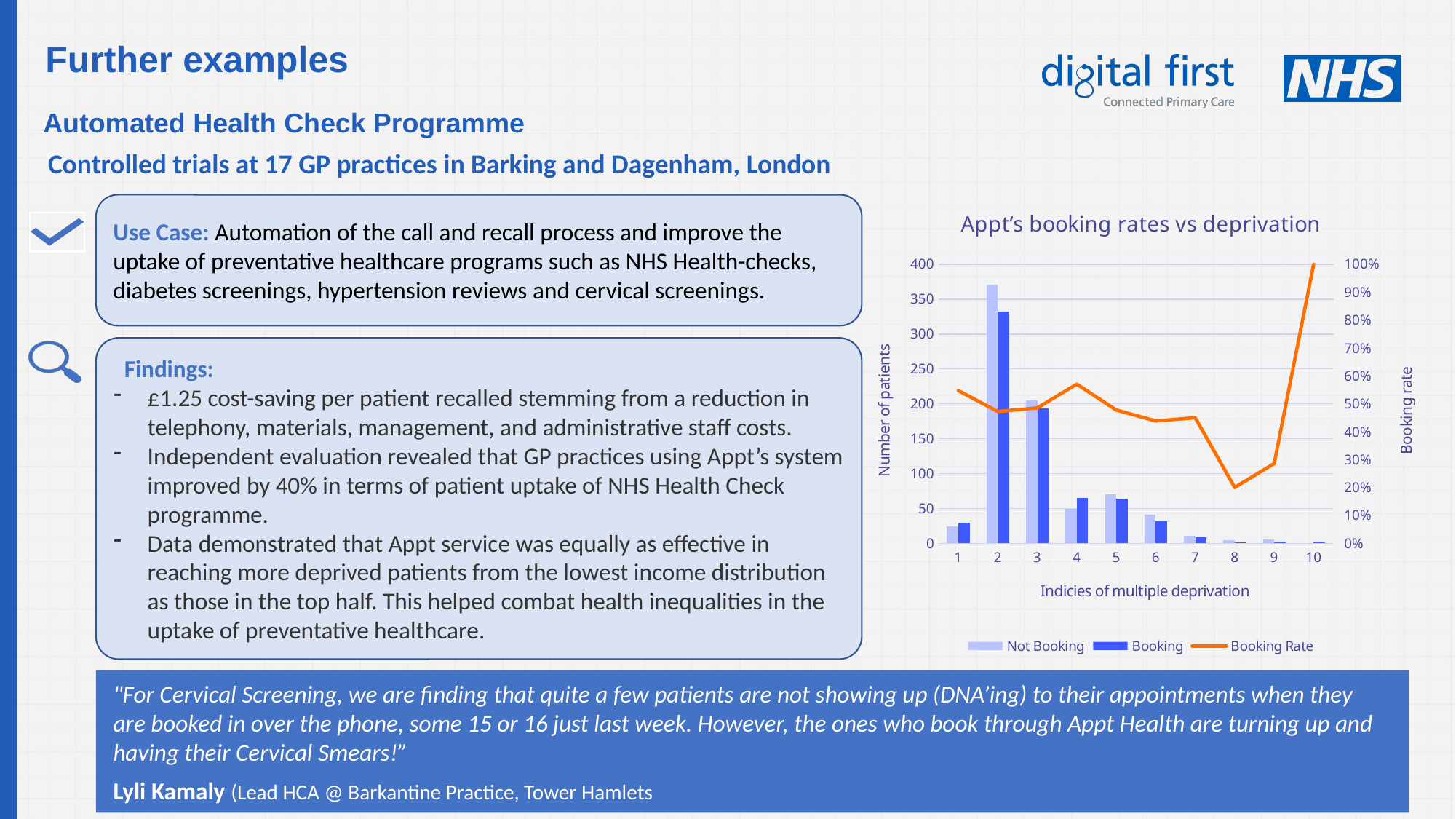
At which index of multiple deprivation is the Booking Rate line at its lowest? 8 At which index of multiple deprivation is the 'Booking' bar highest? 2 At index 2, which is larger: the 'Not Booking' bar or the 'Booking' bar? Not Booking At which index of multiple deprivation is the Booking Rate line at its highest? 10 Does the Booking Rate line rise or fall between index 4 and index 8? fall What kind of chart is 'Appt's booking rates vs deprivation'? A combination bar and line chart How many series does the legend of the 'Appt's booking rates vs deprivation' chart list? 3 Is the Booking Rate at index 10 greater or less than 90%? greater At which index of multiple deprivation is the 'Not Booking' bar highest? 2 How many deprivation index categories are shown on the x axis of the chart? 10